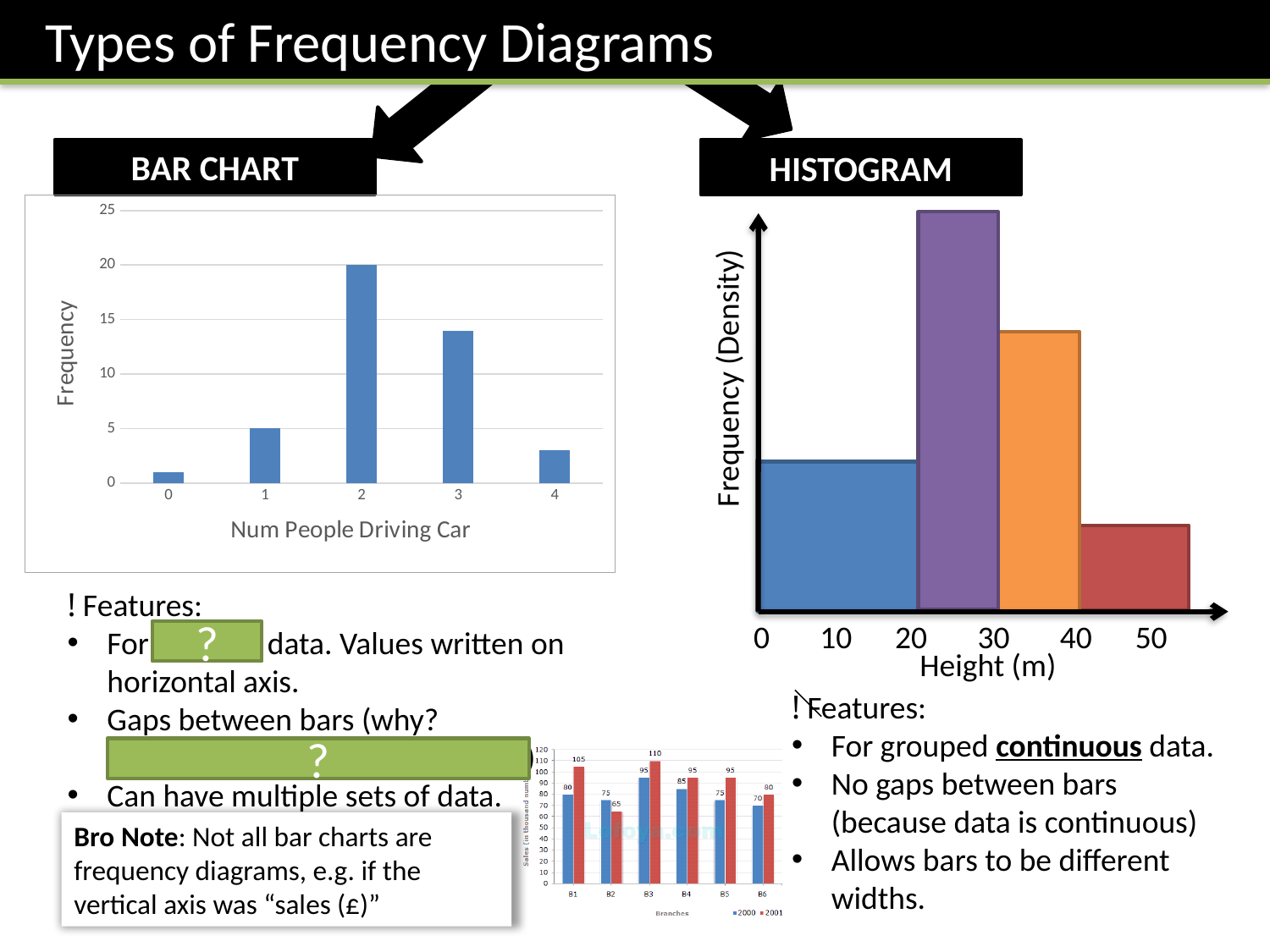
On the bar chart titled 'Num People Driving Car', what is the frequency for 2 people driving the car? 20 On the small bar chart at the bottom with branches B1 to B6, what is the value for B3 in 2001? 110 On the histogram on the right, which height interval has the tallest bar? 20-30 On the histogram on the right, what is the label of the horizontal axis? Height (m) On the bar chart titled 'Num People Driving Car', which category has the lowest frequency? 0 On the bar chart titled 'Num People Driving Car', how many categories are shown on the horizontal axis? 5 On the bar chart titled 'Num People Driving Car', which category has the highest frequency? 2 On the bar chart titled 'Num People Driving Car', is the frequency for 3 people greater or less than 10? greater On the small bar chart at the bottom with branches B1 to B6, what is the difference between the 2001 and 2000 values for B1? 25 On the bar chart titled 'Num People Driving Car', what is the frequency for 1 person driving the car? 5 On the small bar chart at the bottom with branches B1 to B6, how many series does the legend list? 2